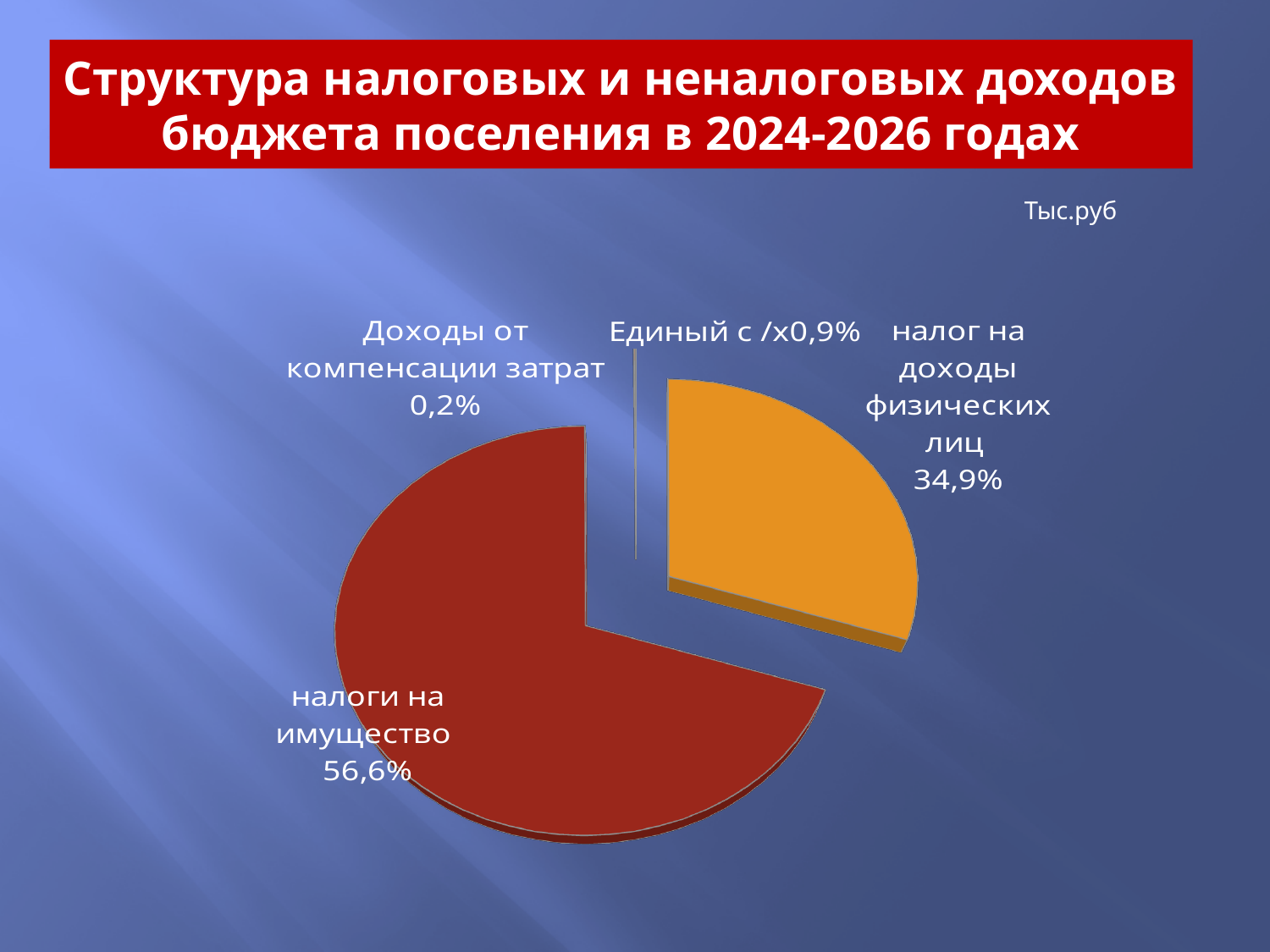
What is the title of the slide containing the chart? Структура налоговых и неналоговых доходов бюджета поселения в 2024-2026 годах What share of the pie is labelled for Доходы от компенсации затрат? 0,2% What kind of chart is shown on the slide? pie chart Which is larger: the share for Единый с/х or the share for Доходы от компенсации затрат? Единый с/х Which category has the smallest slice of the pie? Доходы от компенсации затрат What is the difference in percentage points between налоги на имущество and налог на доходы физических лиц? 21,7 What share of the pie is labelled for налог на доходы физических лиц? 34,9% What share of the pie is labelled for Единый с/х? 0,9% What colour is the slice for налог на доходы физических лиц? orange Which category has the largest slice of the pie? налоги на имущество How many categories are labelled on the pie chart? 4